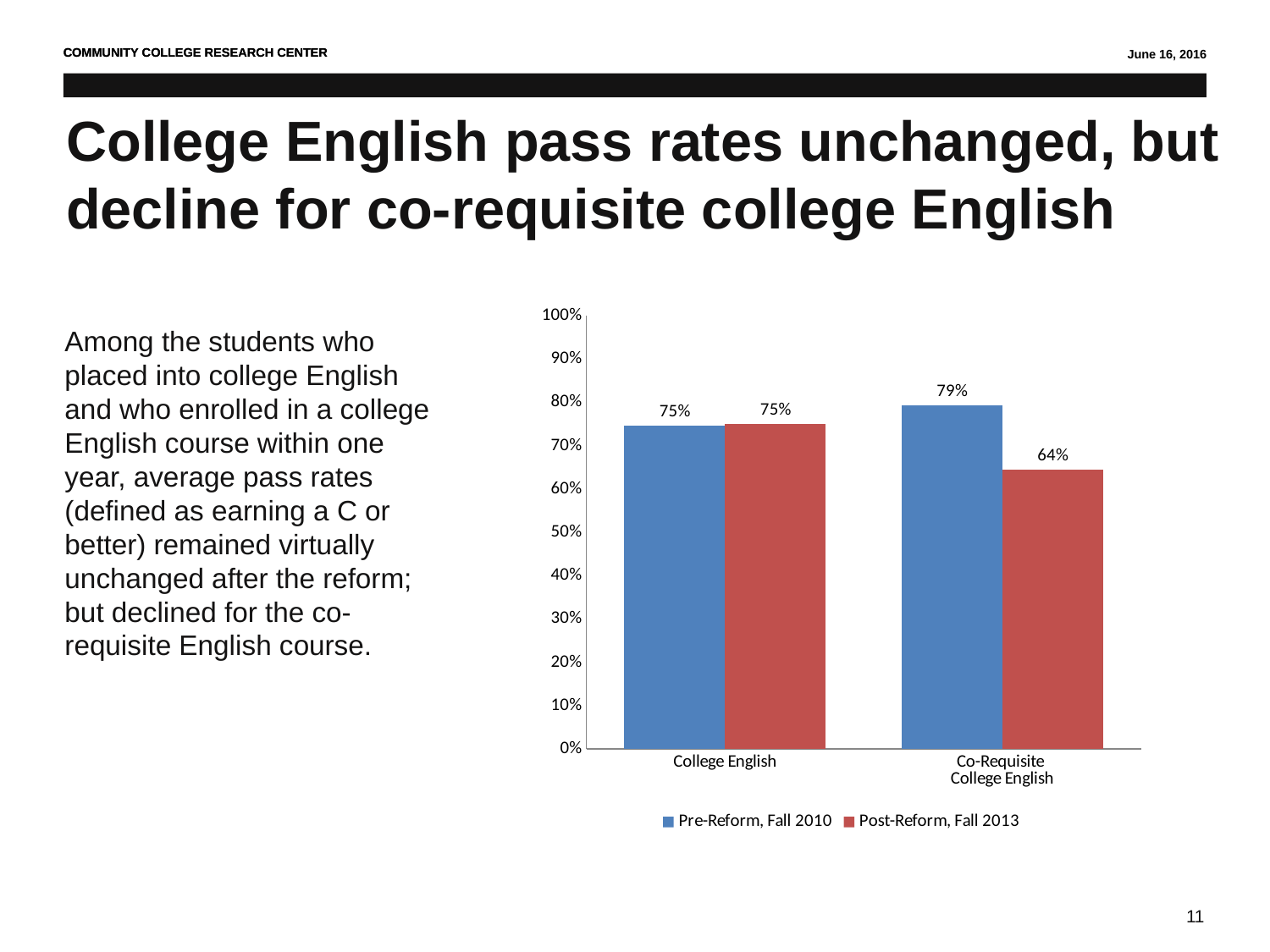
What is the Pre-Reform, Fall 2010 pass rate for Co-Requisite College English? 79% What is the Pre-Reform, Fall 2010 pass rate for College English? 75% Which category has the highest Pre-Reform, Fall 2010 value? Co-Requisite College English Which colour represents the Post-Reform, Fall 2013 series? Red How many categories are shown on the x axis? 2 Which category has the lowest Post-Reform, Fall 2013 value? Co-Requisite College English What kind of chart is shown on the slide? Bar chart What is the Post-Reform, Fall 2013 pass rate for Co-Requisite College English? 64% What is the difference between the Pre-Reform and Post-Reform pass rates for Co-Requisite College English? 15% How many series does the legend list? 2 What is the Post-Reform, Fall 2013 pass rate for College English? 75% For Co-Requisite College English, which is larger: the Pre-Reform, Fall 2010 value or the Post-Reform, Fall 2013 value? Pre-Reform, Fall 2010